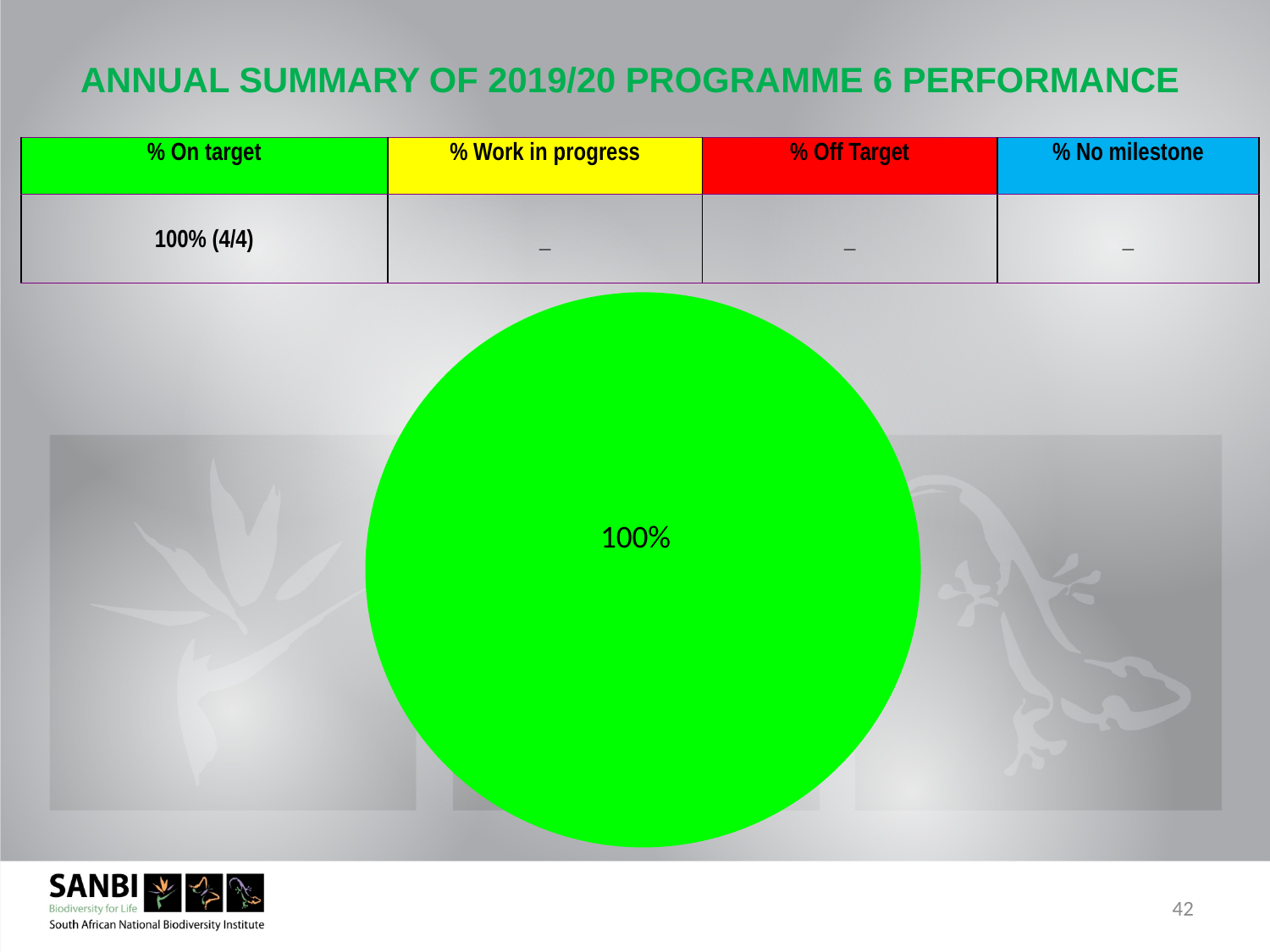
According to the colour key in the table above the chart, which category does the green slice of the pie represent? % On target What share of the pie does the single slice take up? 100% What value is printed on the pie chart's slice? 100% Is the value shown on the pie chart's slice greater or less than 50%? greater What kind of chart is shown on the slide? pie chart What colour is the slice in the pie chart? green How many slices does the pie chart have? 1